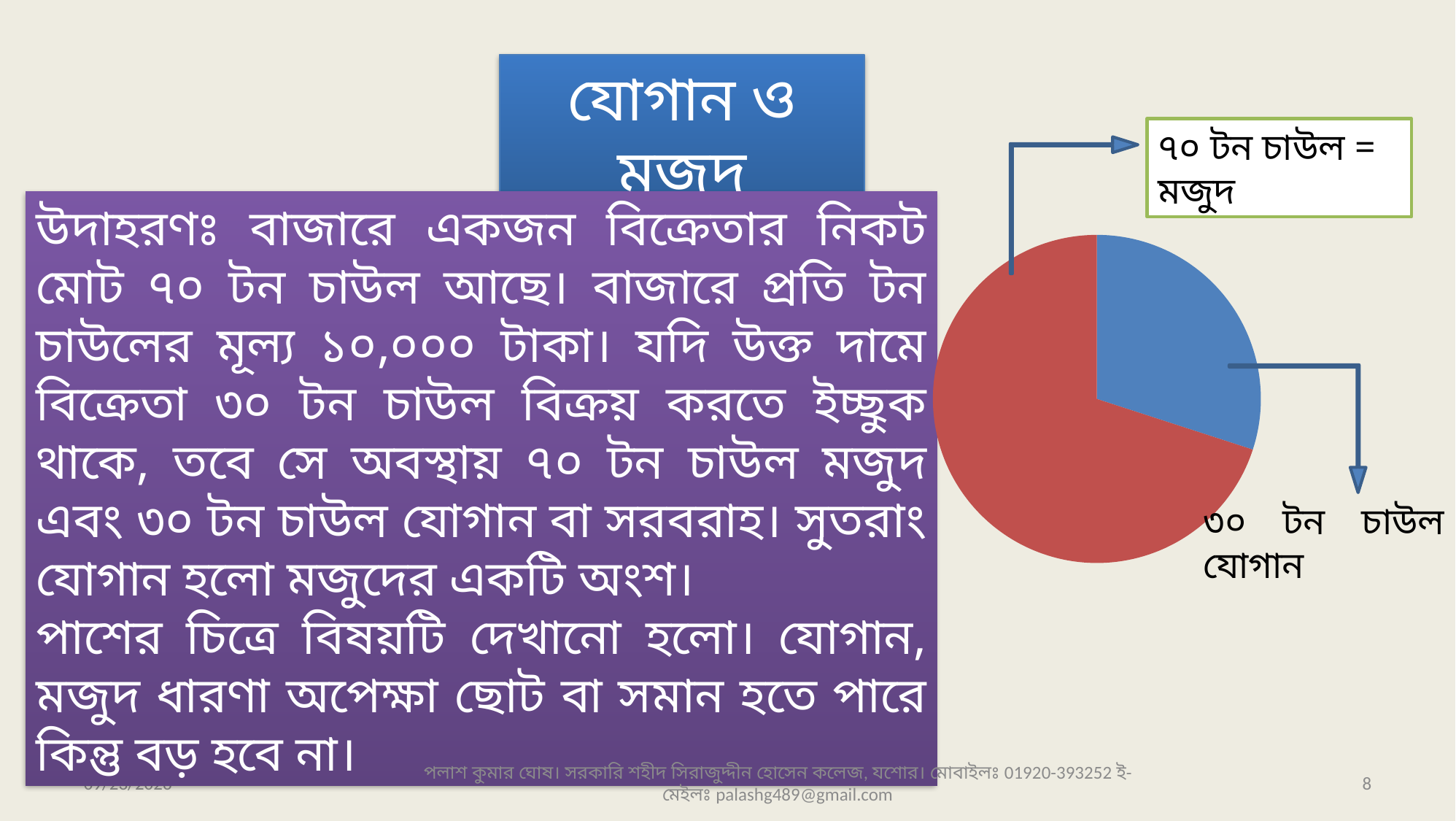
What is the difference between the মজুদ quantity (৭০ টন) and the যোগান quantity (৩০ টন) shown on the pie chart? ৪০ টন According to the callout, what quantity does the blue slice of the pie chart represent? ৩০ টন চাউল Which slice of the pie chart is larger, the red one or the blue one? red What is the title shown above the slide content? যোগান ও মজুদ What kind of chart is shown on the slide? pie chart Which is larger in the pie chart, মজুদ or যোগান? মজুদ Which slice of the pie chart is the smallest? blue (৩০ টন চাউল যোগান) What colour is the slice labelled মজুদ in the pie chart? red How many slices does the pie chart have? 2 According to the callout, what quantity does the red slice of the pie chart represent? ৭০ টন চাউল What share of the pie does the যোগান (৩০ টন) slice represent? 30%